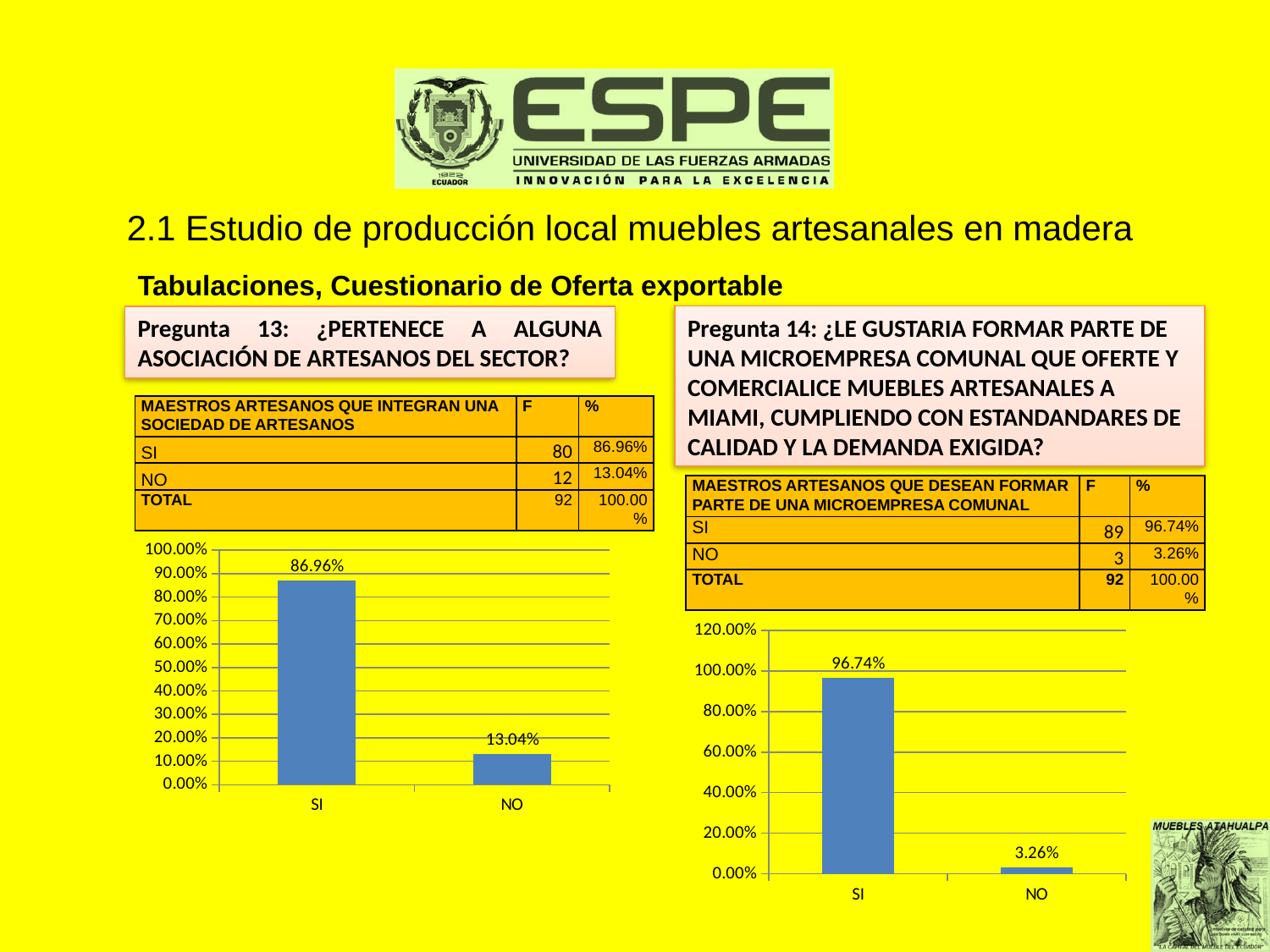
In the right chart (Pregunta 14), what is the value for SI? 96.74% In the left chart (Pregunta 13), what is the value for NO? 13.04% How many categories are shown in the left chart (Pregunta 13)? 2 In the right chart (Pregunta 14), what is the difference between the values for SI and NO? 93.48% What kind of chart is the right chart (Pregunta 14)? Bar chart In the left chart (Pregunta 13), which category has the highest value? SI In the right chart (Pregunta 14), is the value for SI greater or less than 80.00%? greater In the right chart (Pregunta 14), which category has the lowest value? NO In the right chart (Pregunta 14), what is the highest value shown on the vertical axis? 120.00% In the left chart (Pregunta 13), what is the value for SI? 86.96% In the left chart (Pregunta 13), what is the difference between the values for SI and NO? 73.92% In the right chart (Pregunta 14), what is the value for NO? 3.26%